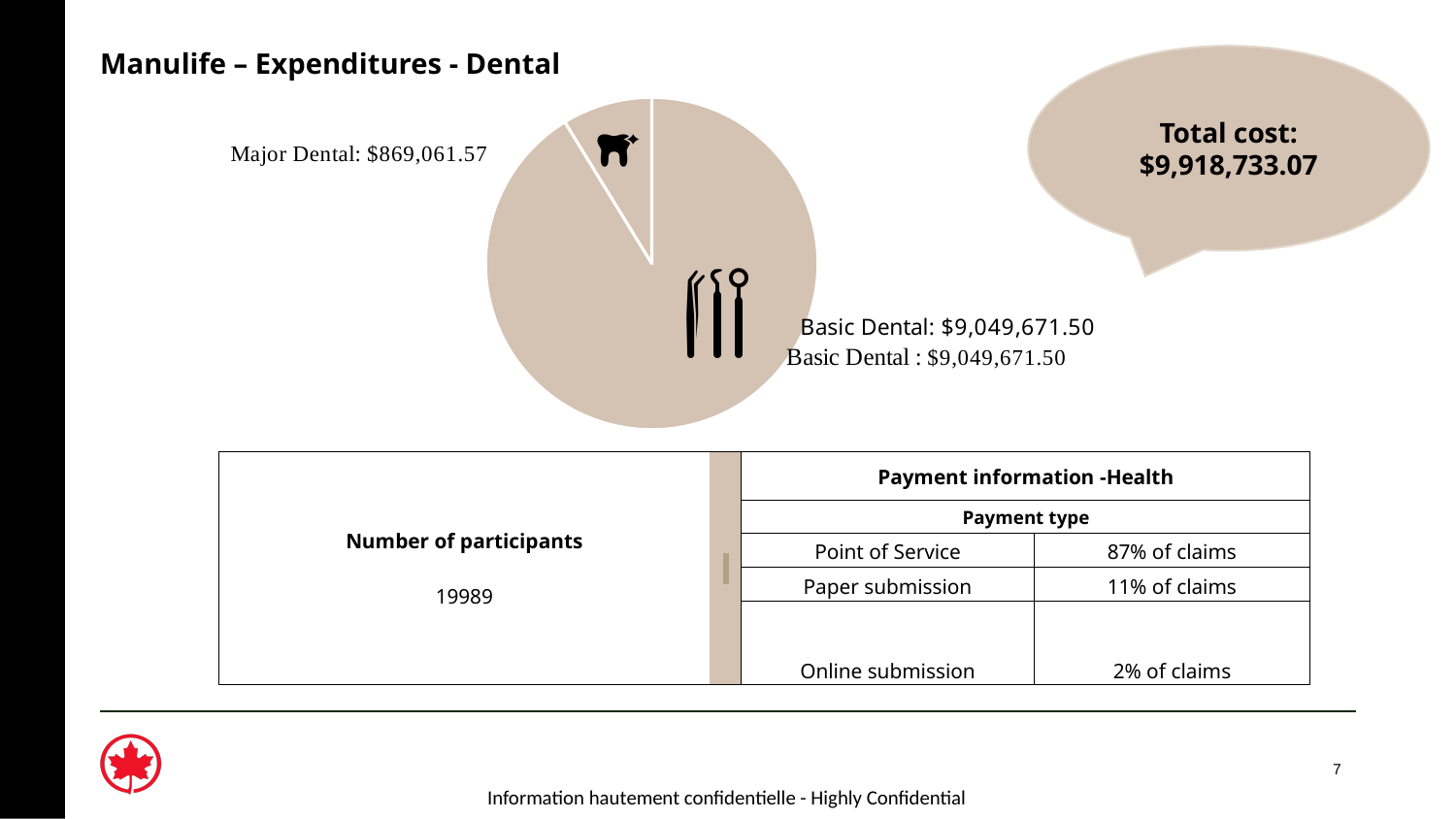
Which slice of the pie chart is the largest? Basic Dental What is the value shown for Basic Dental in the pie chart? $9,049,671.50 What is the difference between the Basic Dental and Major Dental values? $8,180,609.93 Which slice of the pie chart is the smallest? Major Dental How many slices does the pie chart have? 2 What is the total cost shown for the dental expenditures in the pie chart? $9,918,733.07 Which is larger, Basic Dental or Major Dental? Basic Dental What kind of chart is shown on the slide? Pie chart What is the value shown for Major Dental in the pie chart? $869,061.57 What is the title of the slide containing the pie chart? Manulife – Expenditures - Dental